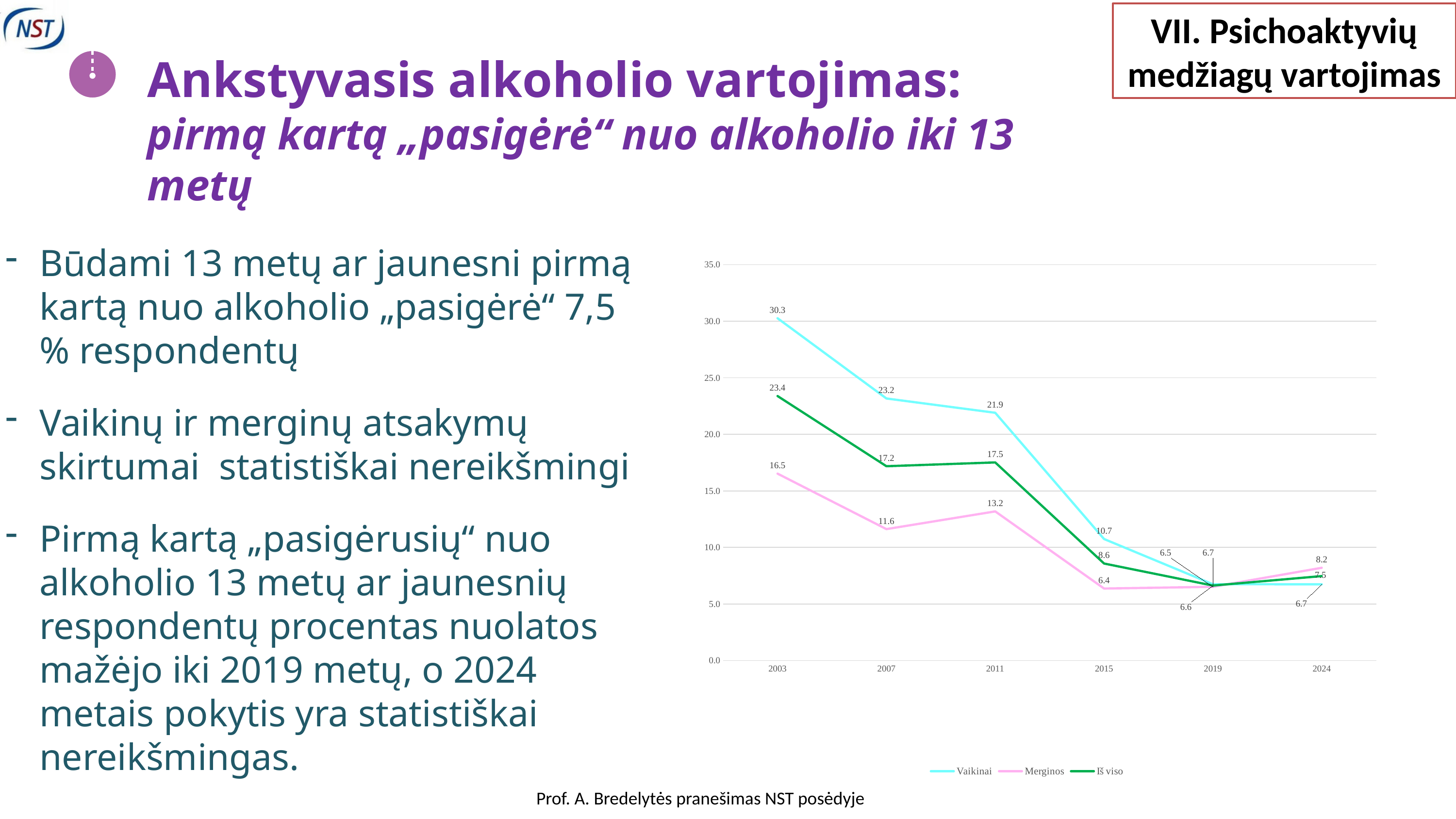
What is the value for Iš viso in 2015? 8.6 How many series does the chart legend list? 3 What is the difference between the Vaikinai and Merginos values in 2003? 13.8 How many years are shown on the x axis of the chart? 6 In which year is the Merginos value lowest? 2015 Does the Iš viso series generally rise or fall from 2003 to 2015? fall What is the value for Vaikinai in 2003? 30.3 In which year is the Vaikinai value highest? 2003 What kind of chart is shown on the slide? line chart What is the value for Merginos in 2024? 8.2 Which is larger in 2007, the Vaikinai value or the Iš viso value? Vaikinai What is the value for Merginos in 2011? 13.2